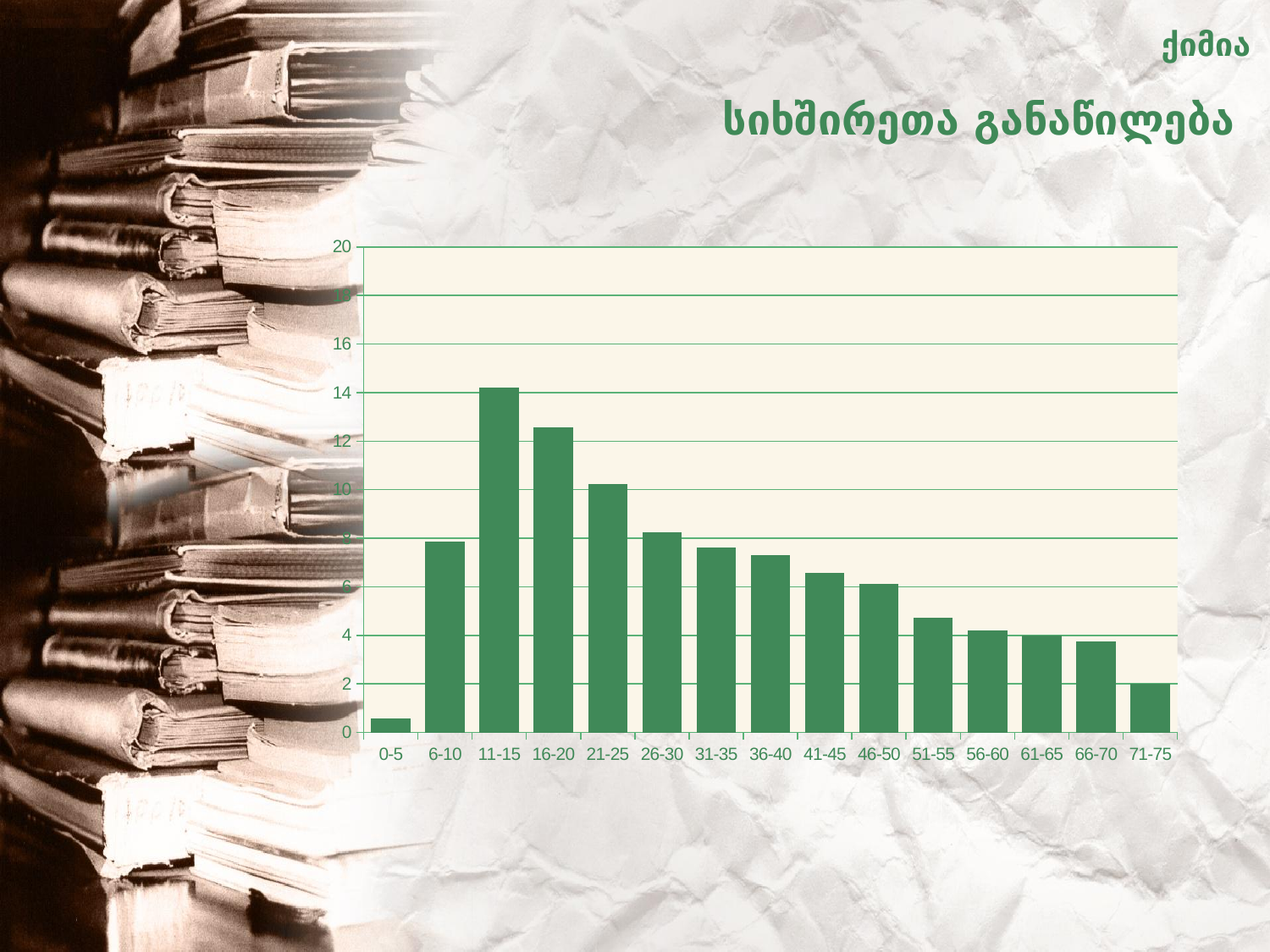
Is the value for 51-55 greater or less than 4? greater What is the title of the chart on the slide? სიხშირეთა განაწილება Which has the larger value, 21-25 or 31-35? 21-25 Which category has the highest bar in the chart? 11-15 Is the value for 0-5 greater or less than 2? less How many categories are shown on the x axis of the chart? 15 Which has the larger value, 11-15 or 16-20? 11-15 Which category has the lowest bar in the chart? 0-5 Do the values rise or fall along the x axis from 11-15 to 71-75? fall Is the value for 11-15 greater or less than 12? greater What kind of chart is shown on the slide? bar chart